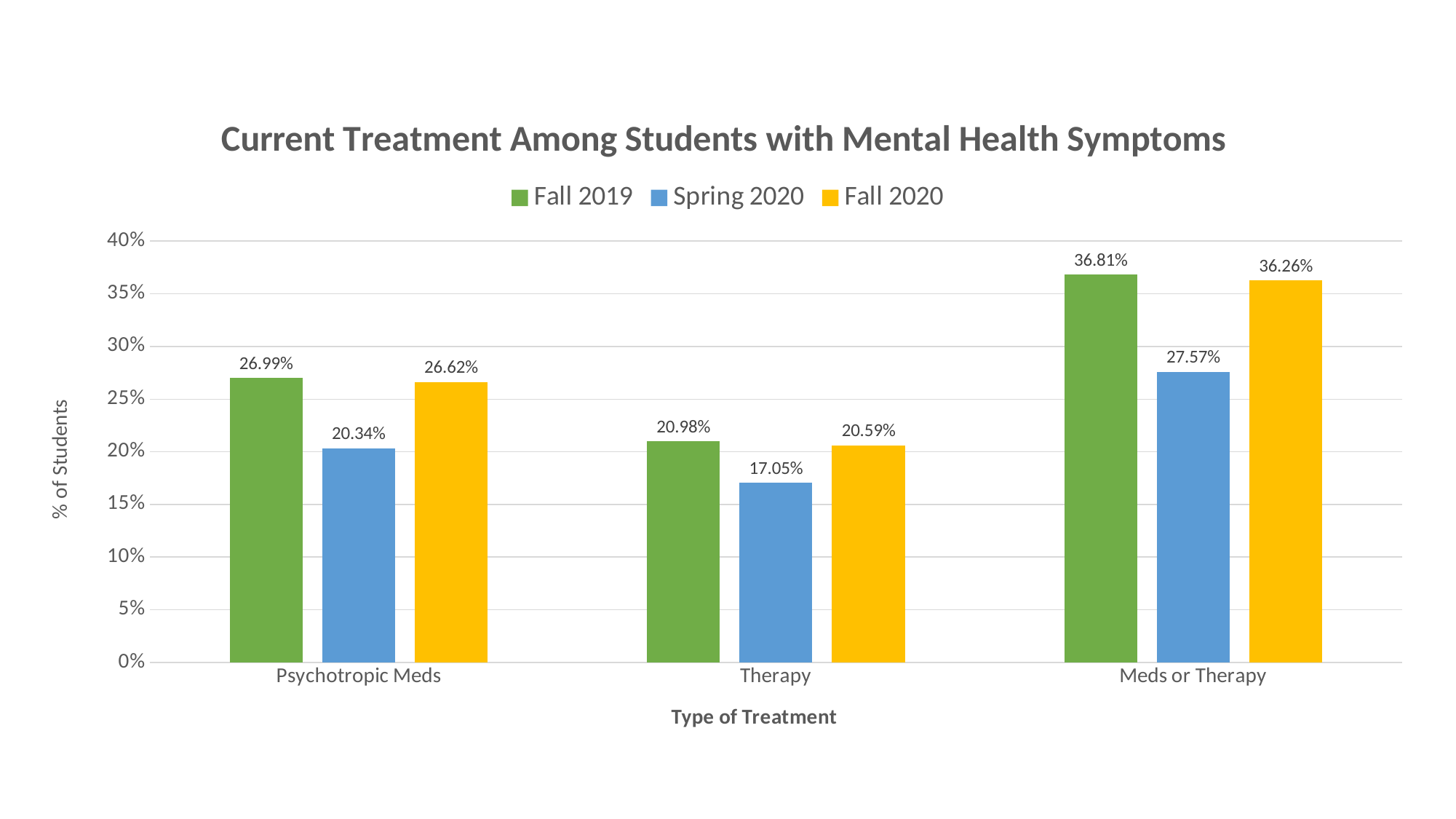
Which treatment type has the lowest Spring 2020 value? Therapy What is the title of the chart? Current Treatment Among Students with Mental Health Symptoms How many treatment types are shown on the x axis? 3 How many series does the legend list? 3 Which treatment type has the highest Fall 2019 value? Meds or Therapy What kind of chart is shown on the slide? bar chart What is the difference between the Fall 2019 and Spring 2020 values for Meds or Therapy? 9.24% What is the Fall 2019 value for Psychotropic Meds? 26.99% Which is larger for Psychotropic Meds: the Fall 2019 value or the Fall 2020 value? Fall 2019 What is the Spring 2020 value for Therapy? 17.05% Is the Spring 2020 value for Meds or Therapy greater or less than 30%? less What is the Fall 2020 value for Meds or Therapy? 36.26%